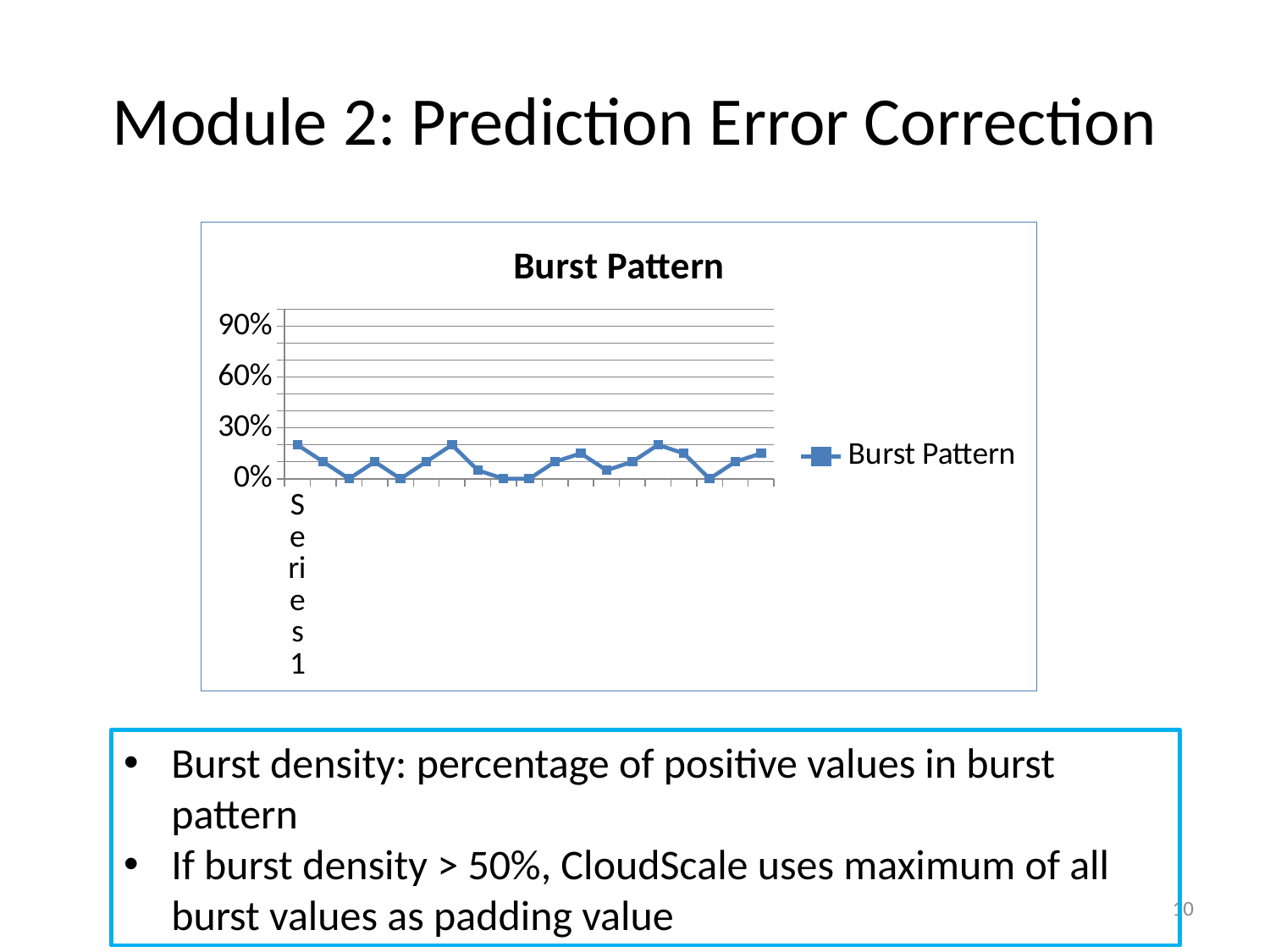
What kind of chart is shown on the slide? line chart Is the highest value of the Burst Pattern series greater or less than 30%? less What is the highest value shown on the vertical axis? 90% What is the title of the chart? Burst Pattern What is the name of the series shown in the legend? Burst Pattern Is the first point of the Burst Pattern series greater or less than 30%? less How many series does the chart's legend list? 1 Is the highest value of the Burst Pattern series greater or less than 60%? less